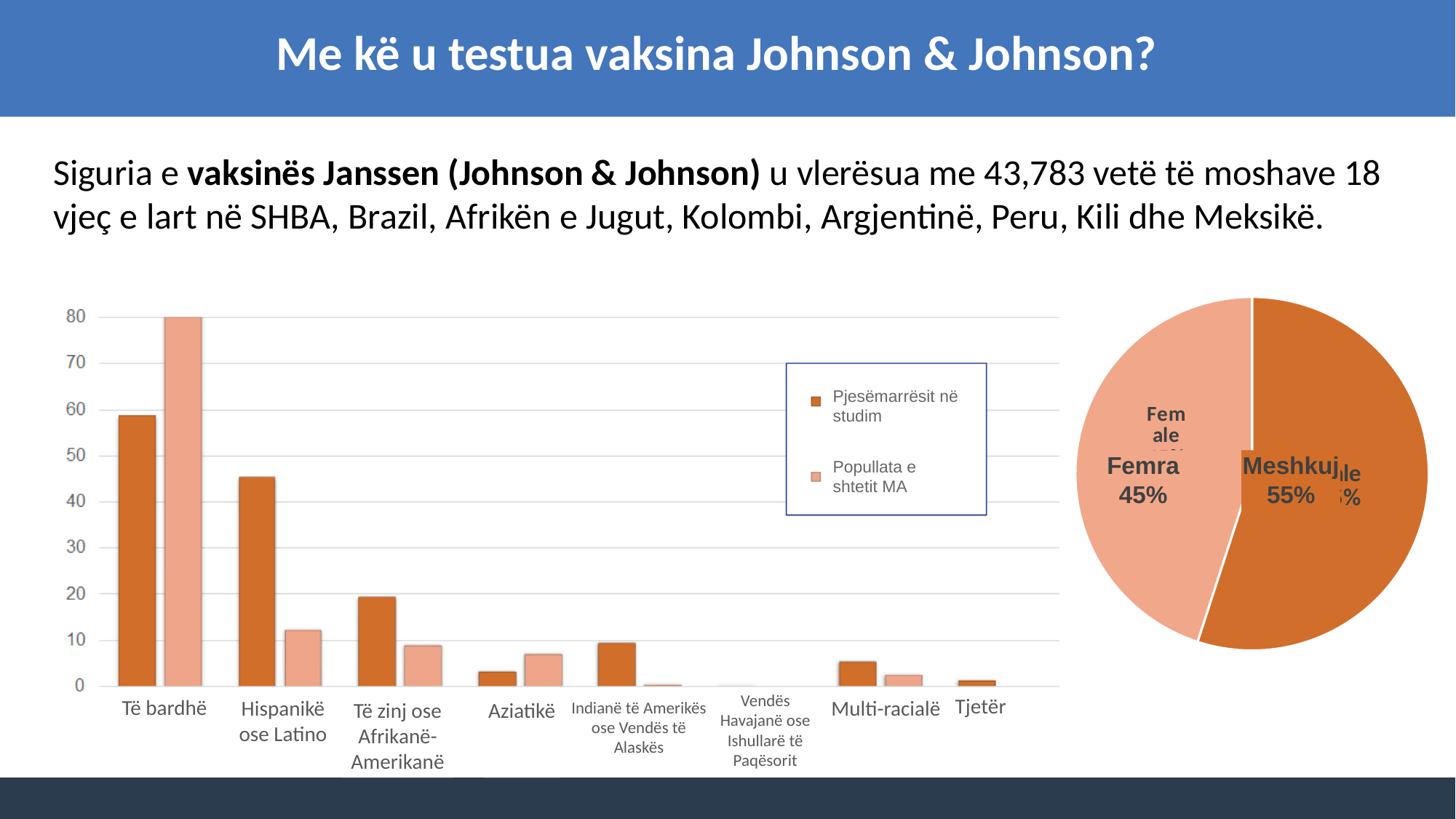
In the bar chart on the left, is the Pjesëmarrësit në studim value for Të bardhë greater or less than 50? greater How many series does the legend of the bar chart on the left list? 2 In the pie chart on the right, what is the difference between the Meshkuj share and the Femra share? 10% In the bar chart on the left, is the Popullata e shtetit MA value for Aziatikë greater or less than 10? less What kind of chart is the chart on the left of the slide? bar chart In the bar chart on the left, which category has the highest value for Pjesëmarrësit në studim? Të bardhë In the bar chart on the left, is the Pjesëmarrësit në studim value for Të zinj ose Afrikanë-Amerikanë greater or less than 30? less How many categories are shown on the x axis of the bar chart on the left? 8 In the bar chart on the left, for Hispanikë ose Latino, which series has the larger value: Pjesëmarrësit në studim or Popullata e shtetit MA? Pjesëmarrësit në studim In the pie chart on the right, what share does Femra have? 45% In the bar chart on the left, for Të bardhë, which series has the larger value: Pjesëmarrësit në studim or Popullata e shtetit MA? Popullata e shtetit MA What kind of chart is the chart on the right of the slide? pie chart